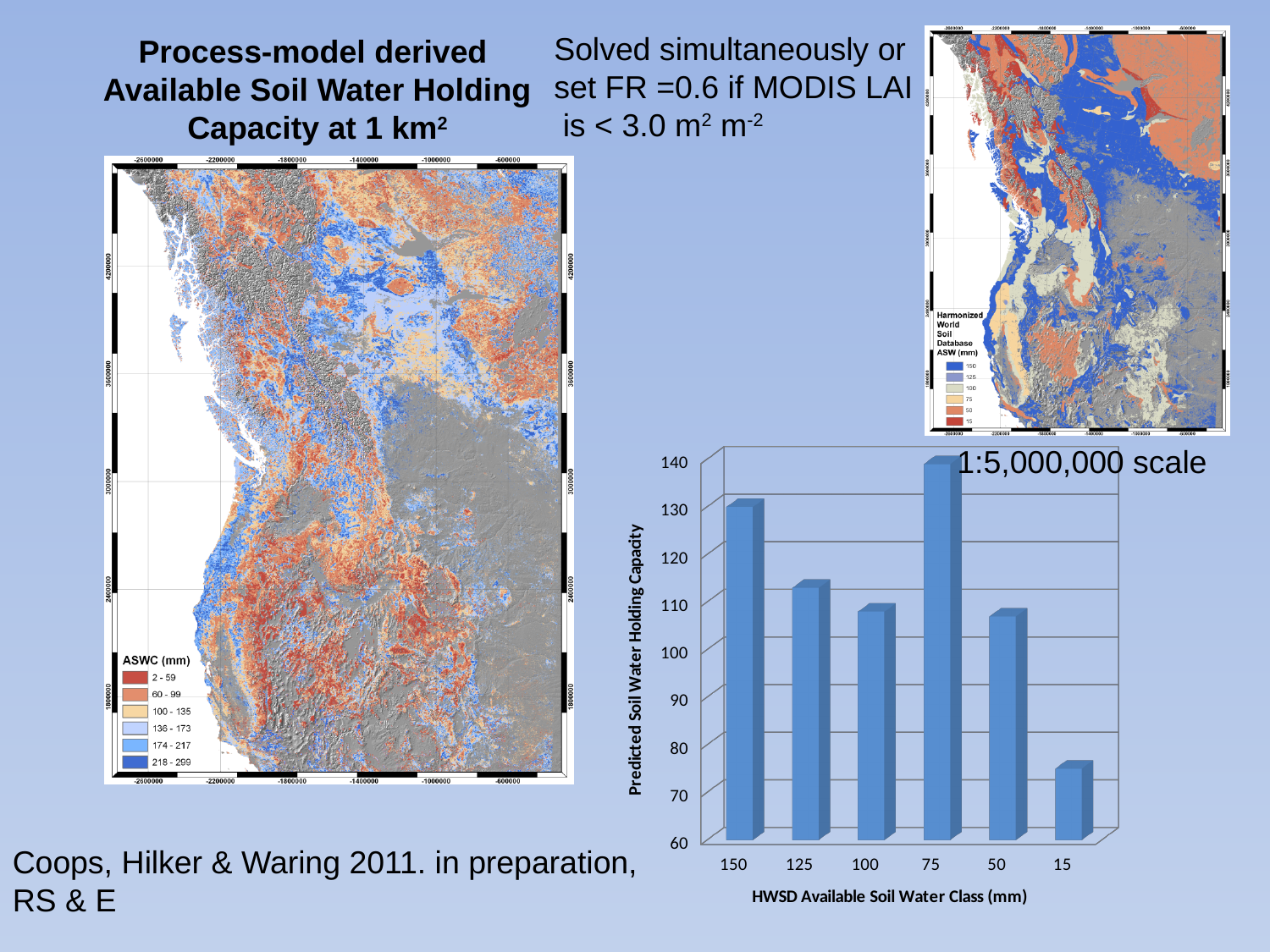
In the bar chart, which has the larger Predicted Soil Water Holding Capacity, class 100 or class 15? 100 What kind of chart is shown at the bottom right of the slide? bar chart In the bar chart, is the Predicted Soil Water Holding Capacity for class 50 greater or less than 110? less In the bar chart, is the Predicted Soil Water Holding Capacity for class 150 greater or less than 120? greater Which HWSD Available Soil Water Class has the lowest Predicted Soil Water Holding Capacity in the bar chart? 15 Which HWSD Available Soil Water Class has the highest Predicted Soil Water Holding Capacity in the bar chart? 75 In the bar chart, is the Predicted Soil Water Holding Capacity for class 15 greater or less than 80? less In the bar chart, which has the larger Predicted Soil Water Holding Capacity, class 150 or class 125? 150 How many HWSD Available Soil Water Class categories are plotted in the bar chart? 6 What is the label of the horizontal axis of the bar chart? HWSD Available Soil Water Class (mm) What is the label of the vertical axis of the bar chart? Predicted Soil Water Holding Capacity